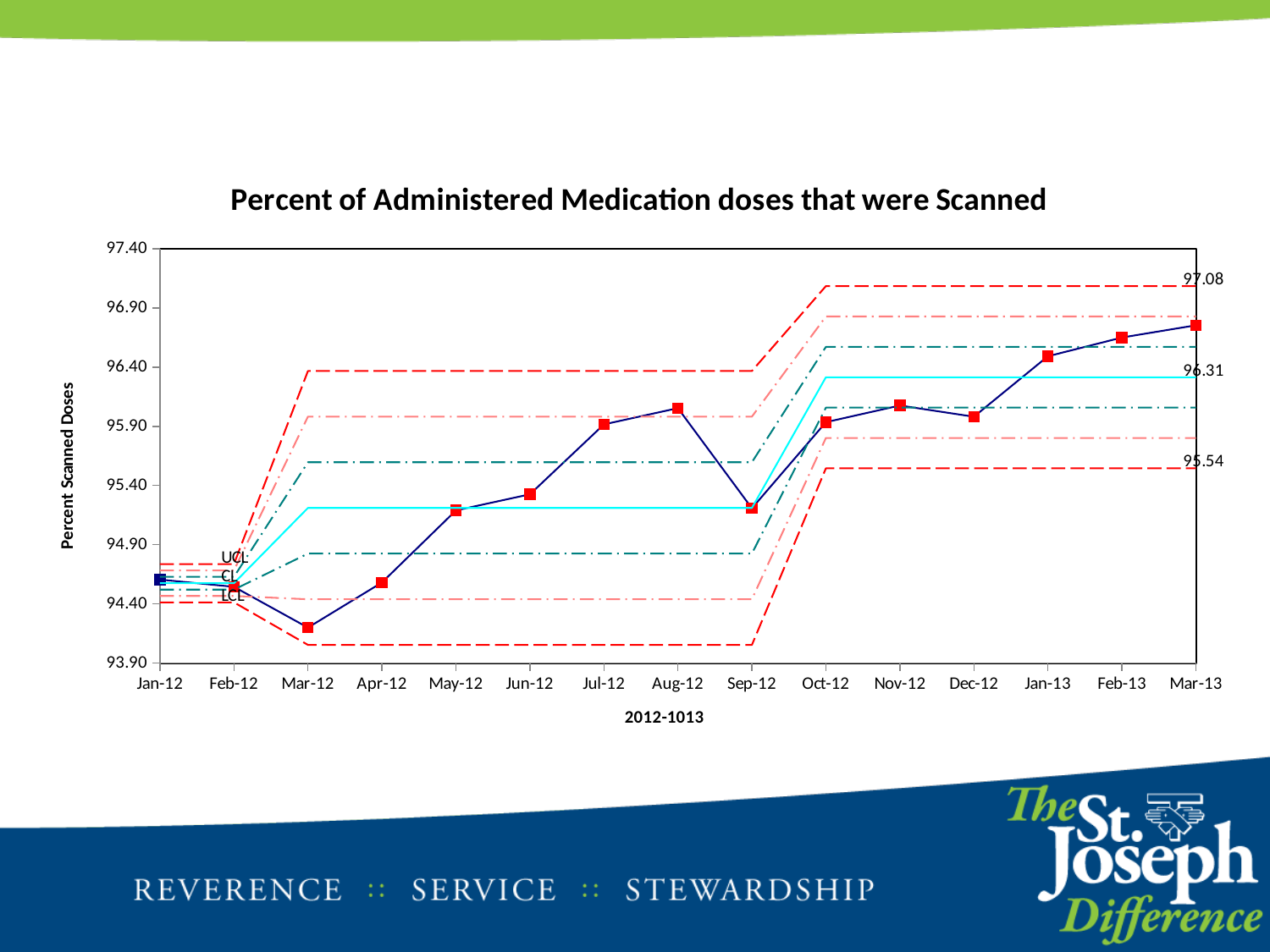
Which month has the highest plotted percent of scanned doses? Mar-13 Which month has the lowest plotted percent of scanned doses? Mar-12 What value is printed for the lower control limit (LCL) at the right end of the chart? 95.54 What kind of chart is shown on the slide? line chart What is the difference between the printed UCL value (97.08) and the printed LCL value (95.54) at the right end of the chart? 1.54 Is the plotted value for Mar-12 greater or less than 94.40? less What value is printed for the upper control limit (UCL) at the right end of the chart? 97.08 How many monthly data points are plotted on the x axis? 15 Is the plotted value for Aug-12 greater or less than 95.90? greater What value is printed for the center line (CL) at the right end of the chart? 96.31 What is the title of the chart? Percent of Administered Medication doses that were Scanned Which month has the larger plotted value, Aug-12 or Sep-12? Aug-12